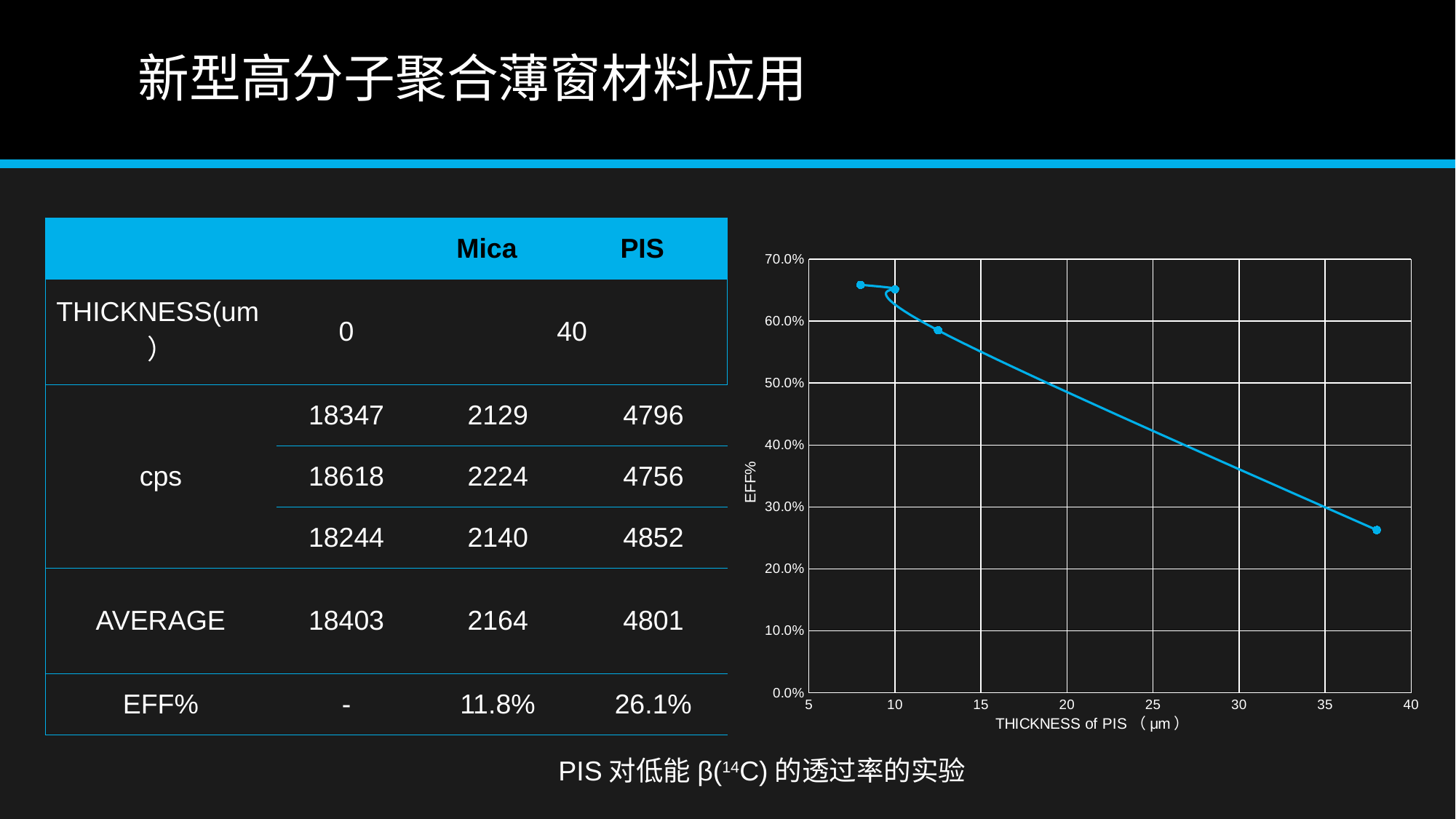
What kind of chart is shown on the right of the slide? line chart In the chart on the right, does EFF% rise or fall as the thickness of PIS increases? fall In the chart on the right, how many data points are plotted? 4 In the chart on the right, what is the highest value shown on the y axis? 70.0% In the chart on the right, is the EFF% at a thickness of about 10 μm larger or smaller than the EFF% at about 38 μm? larger In the chart on the right, is the EFF% value at the smallest thickness (near 8 μm) greater or less than 60.0%? greater In the chart on the right, what is the title of the x axis? THICKNESS of PIS（μm） In the chart on the right, is the EFF% value at the largest thickness (near 38 μm) greater or less than 30.0%? less In the chart on the right, which plotted point has the lowest EFF%: the one at the smallest thickness or the one at the largest thickness? the one at the largest thickness In the chart on the right, is the EFF% value at a thickness of about 12.5 μm greater or less than 60.0%? less In the chart on the right, what is the title of the y axis? EFF%